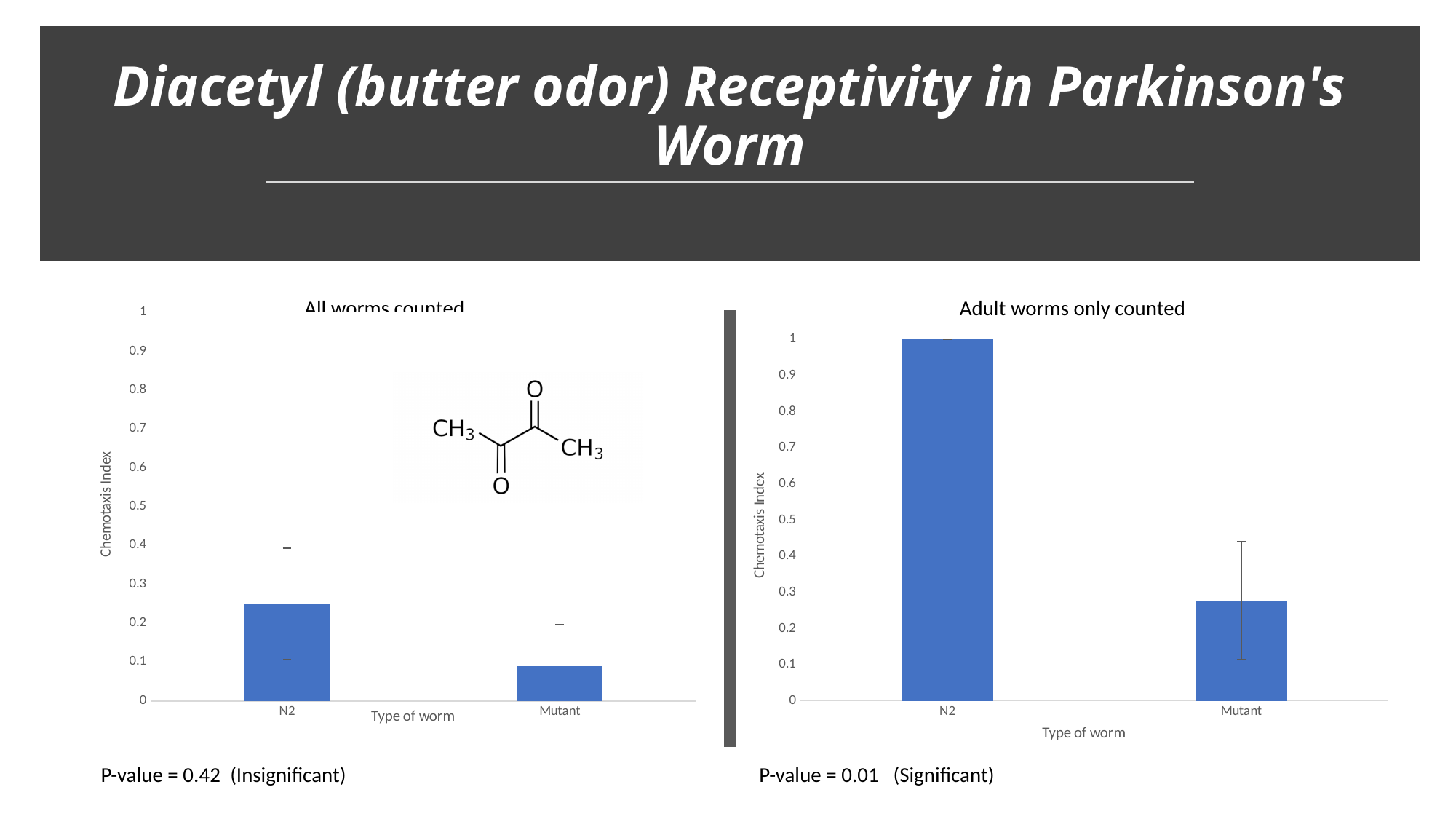
In the 'All worms counted' chart, which type of worm has the higher chemotaxis index? N2 In the 'Adult worms only counted' chart, is the value for N2 larger or smaller than the value for Mutant? larger What is the x-axis label of the 'All worms counted' chart? Type of worm In the 'All worms counted' chart, is the value for N2 greater or less than 0.2? greater What is the y-axis label of the 'Adult worms only counted' chart? Chemotaxis Index In the 'All worms counted' chart, is the value for Mutant greater or less than 0.2? less In the 'Adult worms only counted' chart, is the value for Mutant greater or less than 0.5? less How many types of worm are shown in the 'Adult worms only counted' chart? 2 In the 'Adult worms only counted' chart, which type of worm has the higher chemotaxis index? N2 In the 'All worms counted' chart, which type of worm has the lowest chemotaxis index? Mutant In the 'Adult worms only counted' chart, what is the chemotaxis index for N2? 1 What kind of chart is the 'All worms counted' chart? bar chart